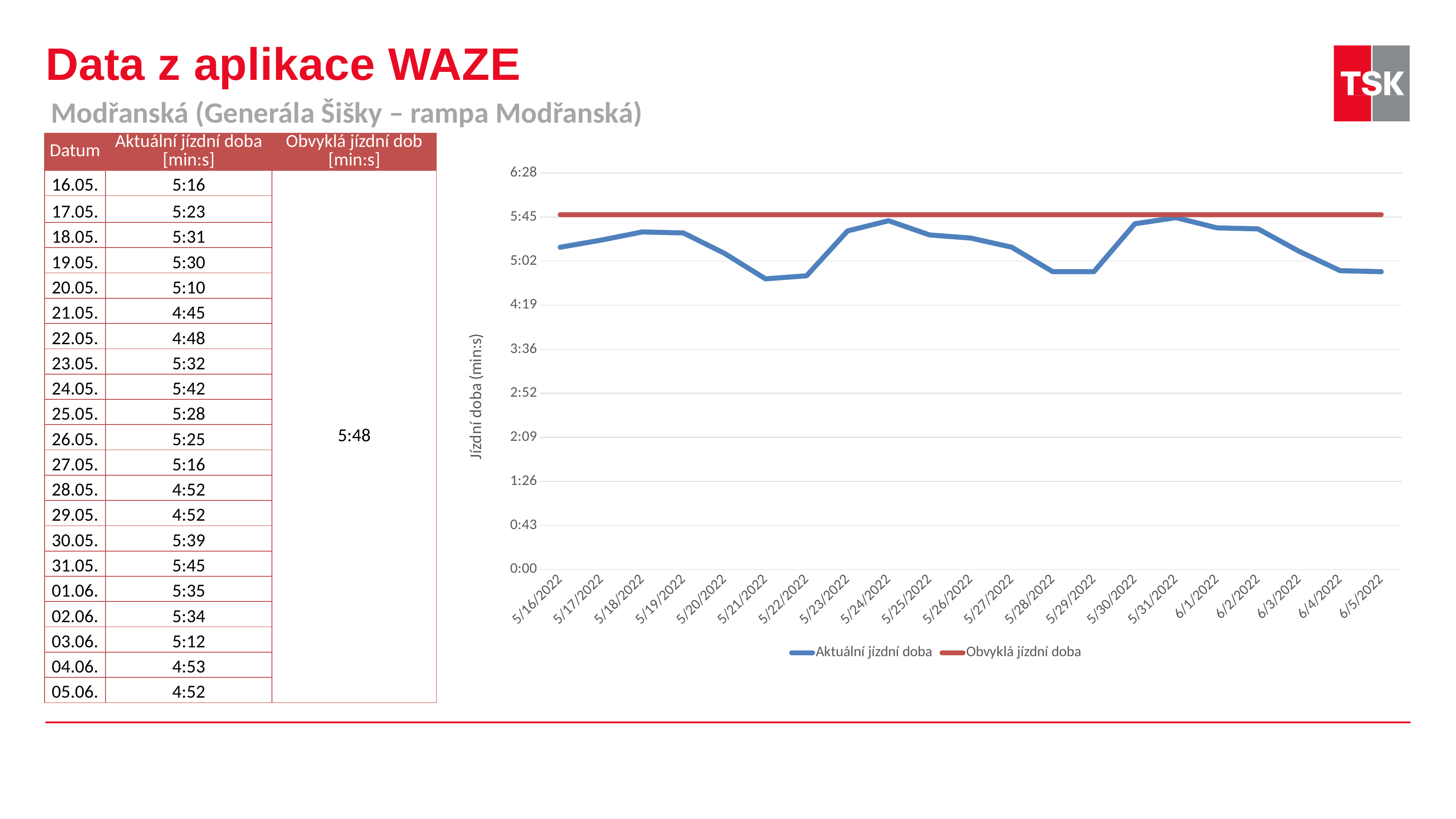
What is the Aktuální jízdní doba for 24.05. according to the slide? 5:42 How many dates are plotted along the x axis of the chart? 21 How many series does the chart legend list? 2 What kind of chart is shown on the slide? line chart What is the Aktuální jízdní doba for 21.05. according to the slide? 4:45 What colour is the Obvyklá jízdní doba line in the chart? red What is the value of Obvyklá jízdní doba shown on the slide? 5:48 On which date is the Aktuální jízdní doba highest? 31.05. On which date is the Aktuální jízdní doba lowest? 21.05. Which is larger, the Aktuální jízdní doba on 5/24/2022 or on 5/28/2022? 5/24/2022 Does the Aktuální jízdní doba line rise or fall from 6/2/2022 to 6/4/2022? fall Is the Aktuální jízdní doba for 5/21/2022 greater or less than 5:02? less